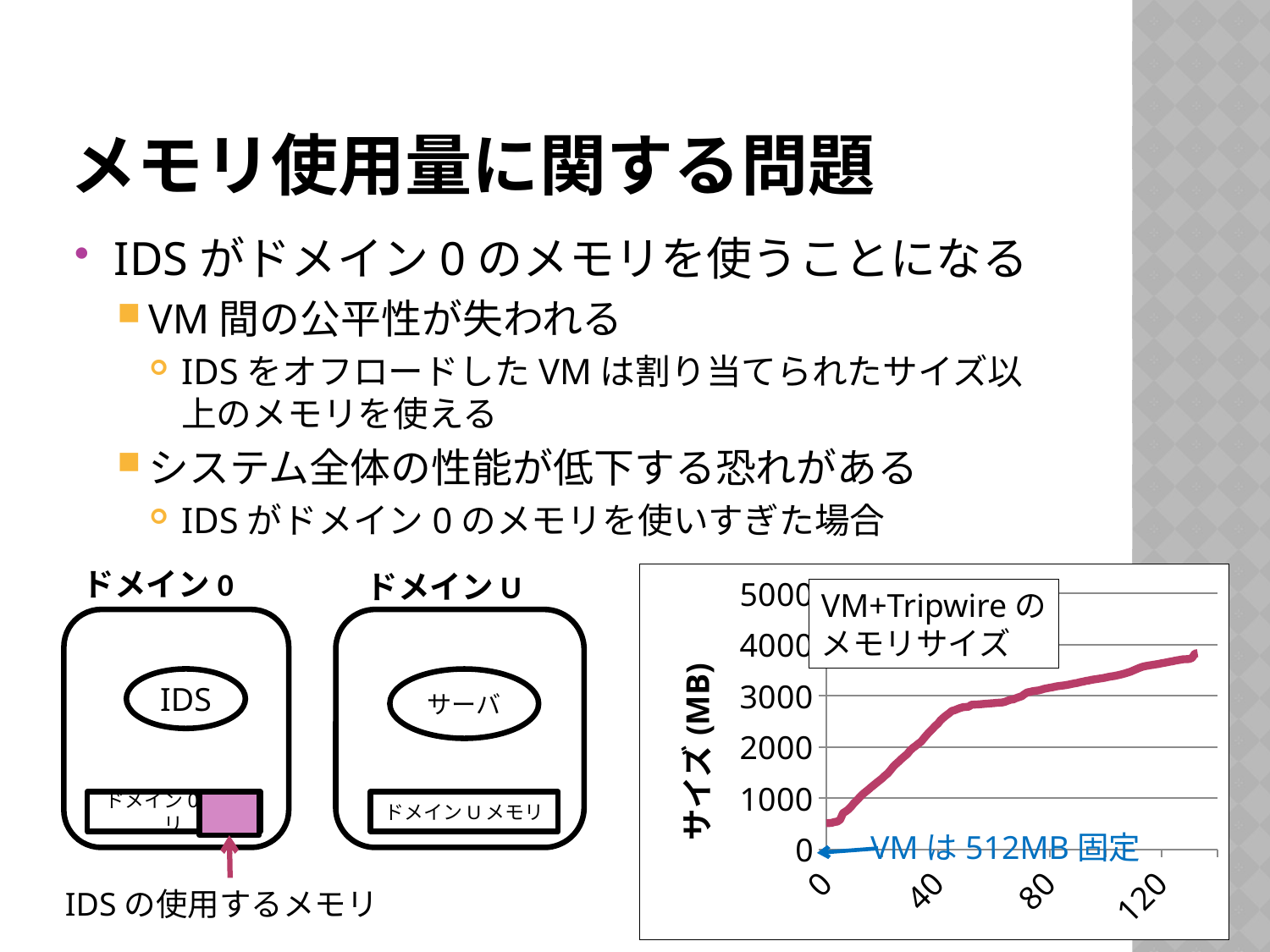
What is the highest tick value shown on the y-axis of the chart? 5000 Is the highest value reached by the line greater or less than 4000? less Is the value of the line at x = 0 greater or less than 1000? less Do the values in the chart rise or fall as the x-axis value increases? rise Is the value of the line at x = 120 greater or less than 4000? less What is the label of the y-axis of the chart? サイズ (MB) What does the text box inside the chart say the plotted line represents? VM+Tripwire のメモリサイズ Which is larger, the value of the line at x = 0 or at x = 120? x = 120 How many lines (series) are plotted in the chart? 1 What kind of chart is shown on the slide? line chart